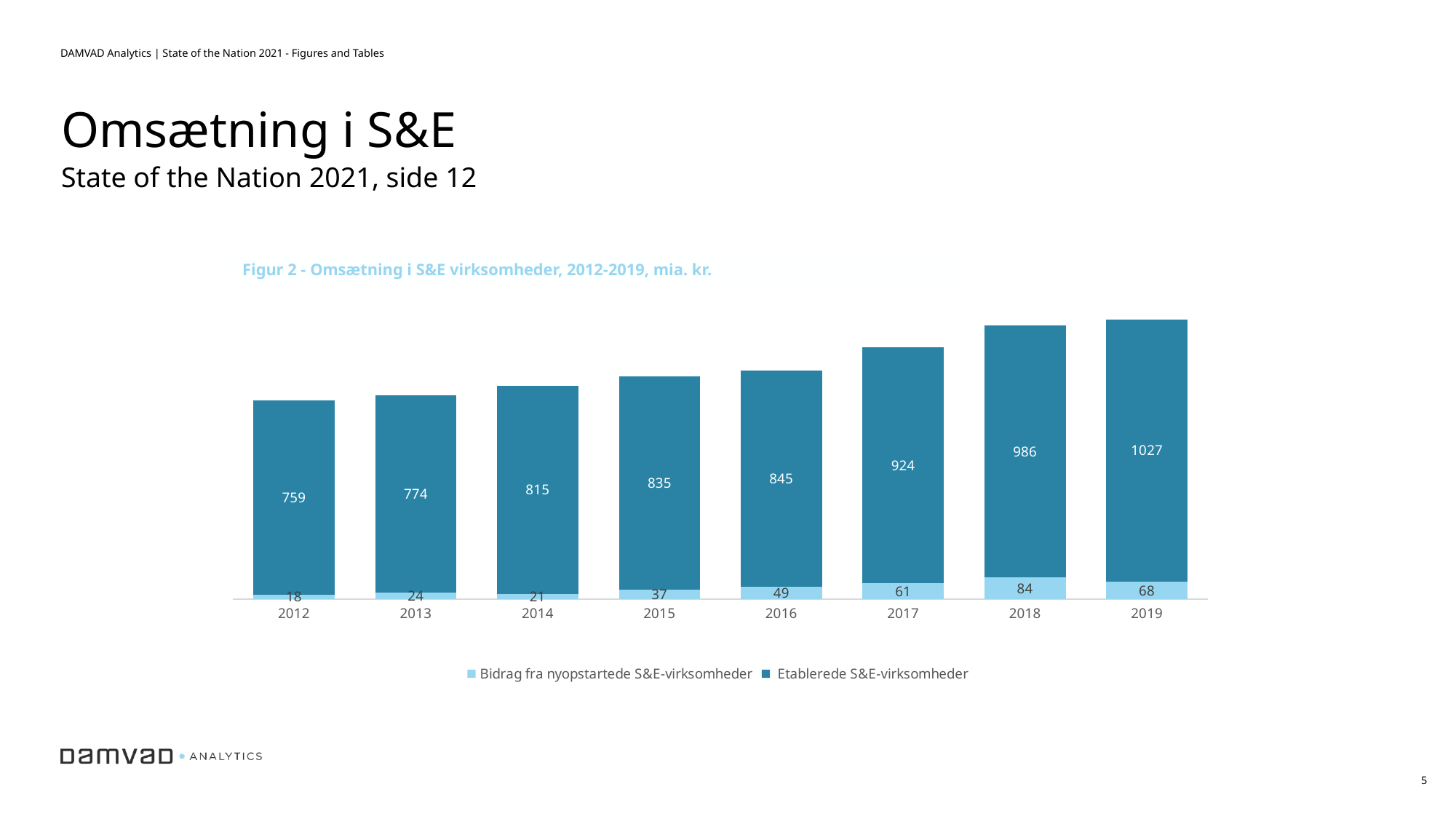
What is the value for Etablerede S&E-virksomheder in 2012? 759 What kind of chart is shown? Stacked bar chart Which year has the highest value for Bidrag fra nyopstartede S&E-virksomheder? 2018 How many series does the legend list? 2 Which is larger: the Bidrag fra nyopstartede S&E-virksomheder value for 2018 or for 2019? 2018 Do the Etablerede S&E-virksomheder values rise or fall from 2012 to 2019? Rise What is the total of the stacked bar for 2017? 985 Which year has the lowest value for Etablerede S&E-virksomheder? 2012 What is the value for Bidrag fra nyopstartede S&E-virksomheder in 2015? 37 What is the value for Etablerede S&E-virksomheder in 2019? 1027 What is the difference between the Etablerede S&E-virksomheder values for 2019 and 2018? 41 How many years are shown on the x axis? 8